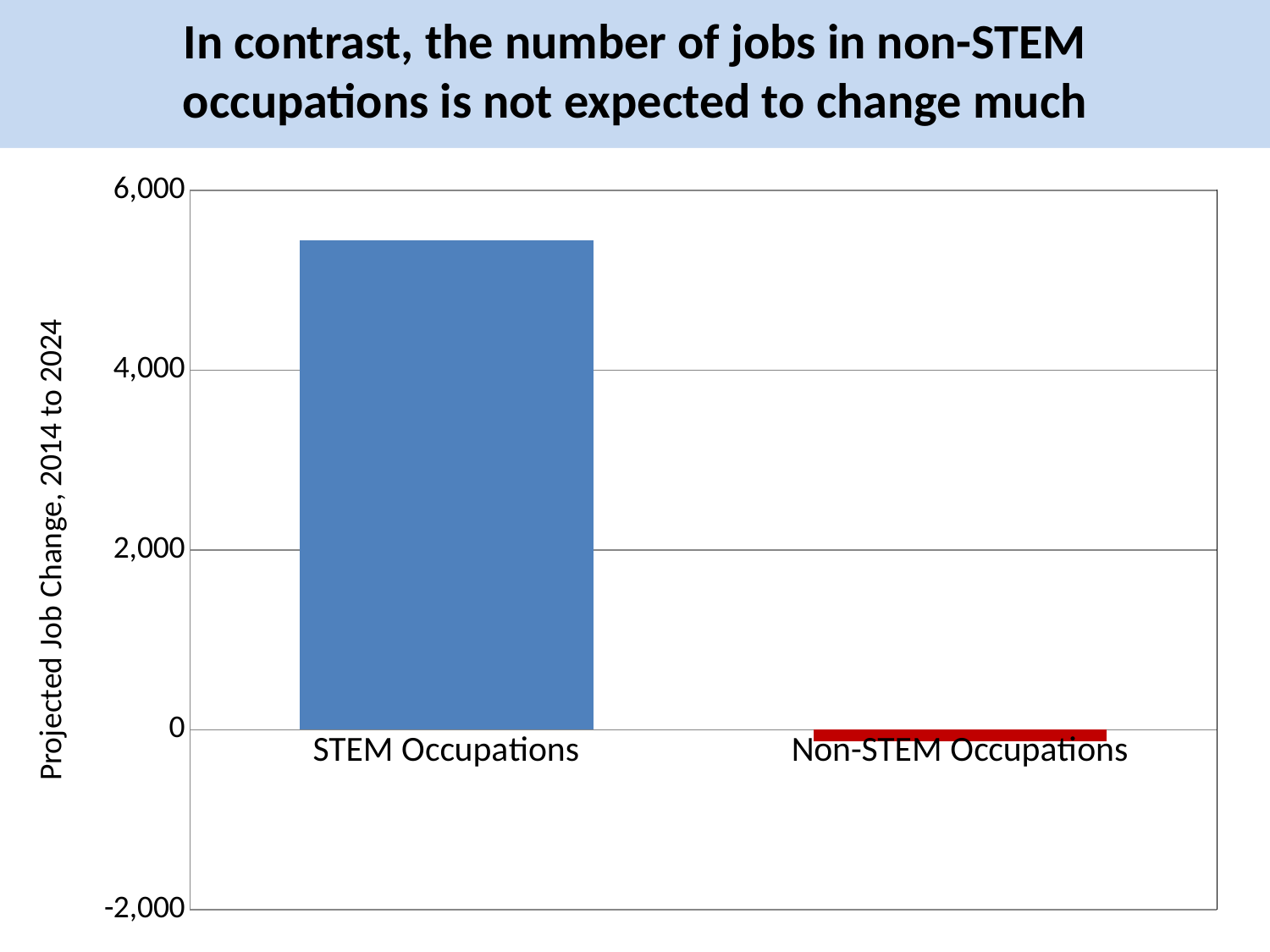
What is the label of the vertical axis? Projected Job Change, 2014 to 2024 What kind of chart is shown on the slide? bar chart Is the projected job change for STEM Occupations greater or less than 4,000? greater Do the values rise or fall from STEM Occupations to Non-STEM Occupations along the x axis? fall Which is larger, the projected job change for STEM Occupations or for Non-STEM Occupations? STEM Occupations How many categories are shown on the x axis? 2 Is the projected job change for Non-STEM Occupations greater or less than 2,000? less Which category has the lowest projected job change? Non-STEM Occupations Which category has the highest projected job change? STEM Occupations Is the projected job change for STEM Occupations greater or less than 6,000? less What colour is the bar for Non-STEM Occupations? red